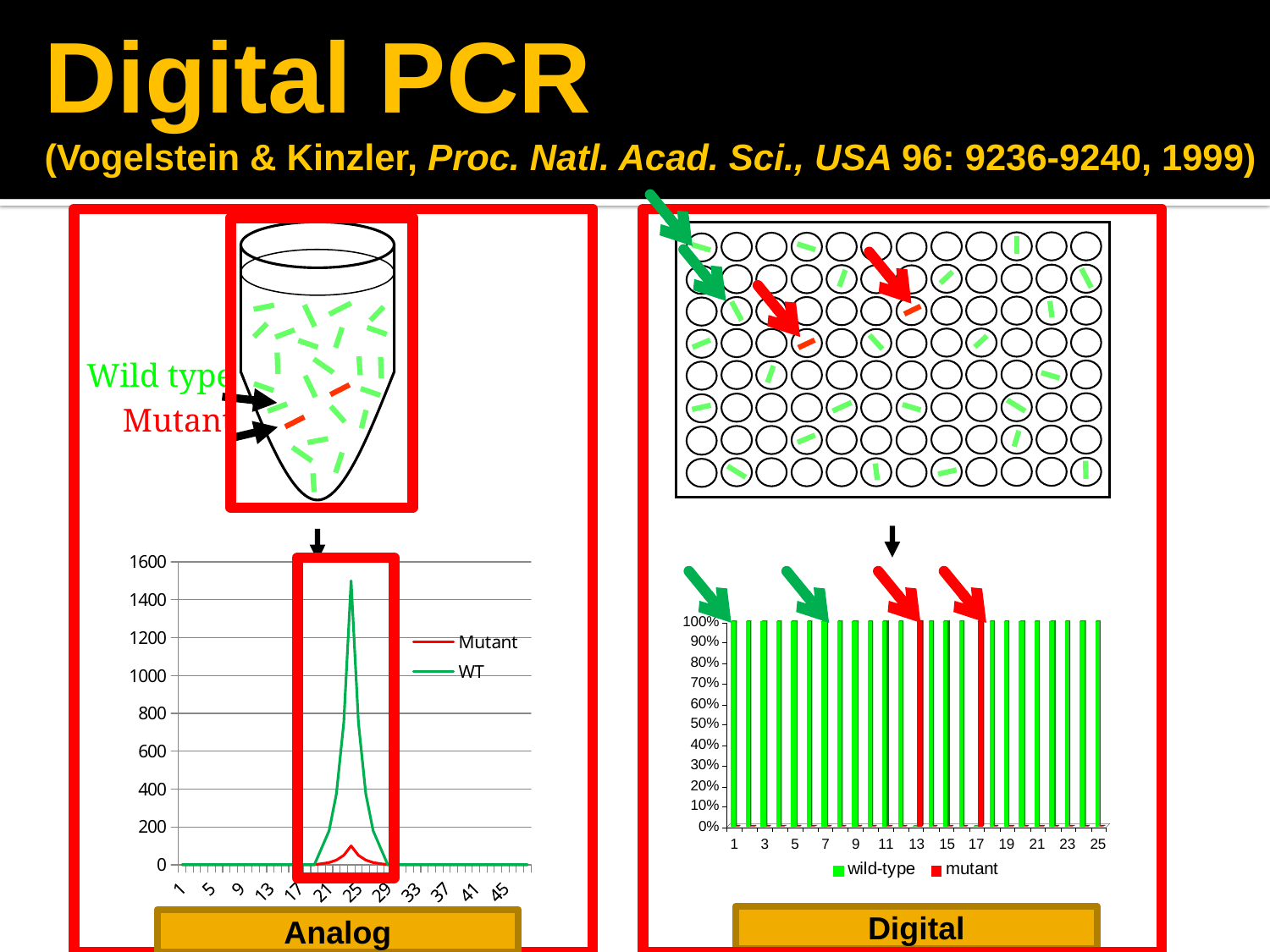
What are the two legend entries of the Analog chart? Mutant and WT How many categories are shown on the x axis of the Digital chart? 25 What are the two legend entries of the Digital chart? wild-type and mutant In the Digital chart, what is the value of the wild-type bar for category 1? 100% How many series does the legend of the Digital chart list? 2 What kind of chart is the Analog chart on the left of the slide? line chart In the Analog chart, which series reaches the higher peak, WT or Mutant? WT How many series does the legend of the Analog chart list? 2 In the Analog chart, is the peak value of the WT series greater or less than 1400? greater What kind of chart is the Digital chart on the right of the slide? bar chart In the Digital chart, which series does the bar at category 13 belong to? mutant In the Analog chart, is the peak value of the Mutant series greater or less than 200? less